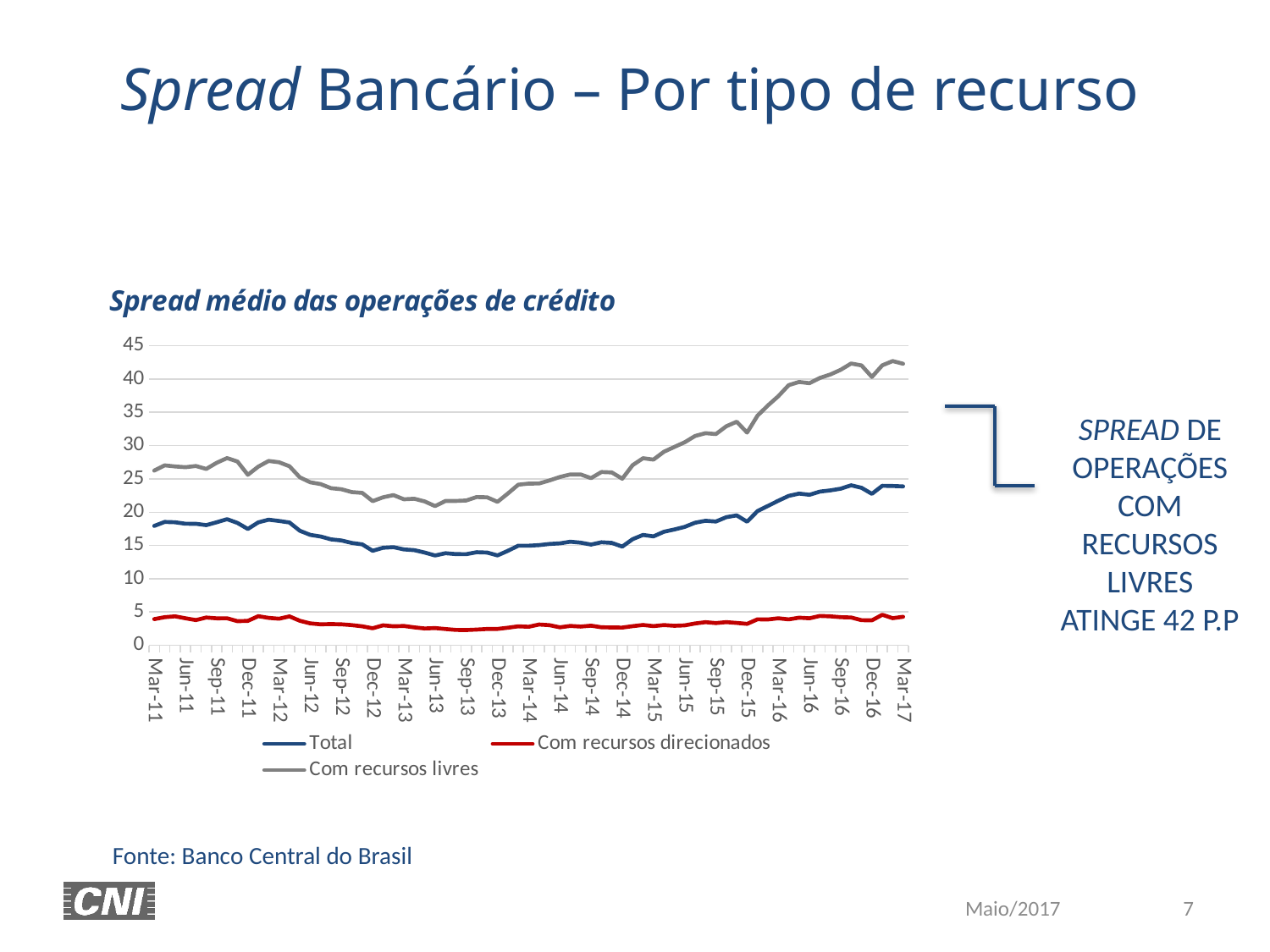
Is the value for Com recursos direcionados at Mar-17 greater or less than 5? less What kind of chart is shown on the slide? line chart Which series has the highest values across the whole period? Com recursos livres Which series has the lowest values across the whole period? Com recursos direcionados How many series does the chart legend list? 3 Is the value for Total at Mar-17 greater or less than 20? greater Does the Com recursos livres series rise or fall between Dec-14 and Mar-17? rise What is the title of the chart? Spread médio das operações de crédito Is the value for Total at Mar-11 greater or less than 15? greater Which series is plotted with the red line? Com recursos direcionados